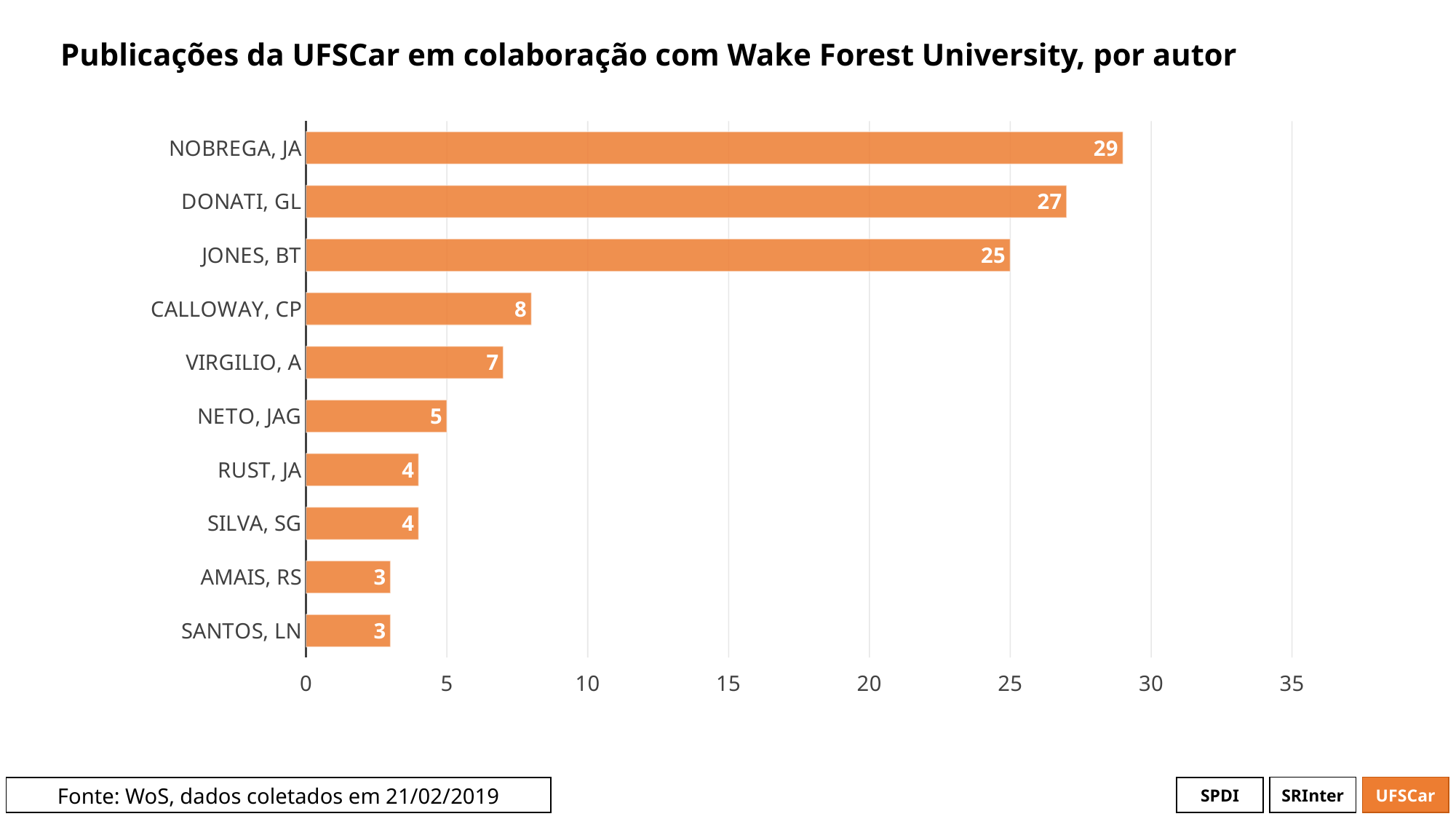
Which author has the highest number of publications? NOBREGA, JA How many authors are shown in the chart? 10 What is the value shown for CALLOWAY, CP? 8 What kind of chart is shown on the slide? bar chart Is the value for DONATI, GL greater or less than 25? greater What is the difference between the values for JONES, BT and CALLOWAY, CP? 17 How many publications does NOBREGA, JA have? 29 What is the value shown for SANTOS, LN? 3 What is the title of the chart? Publicações da UFSCar em colaboração com Wake Forest University, por autor What is the value shown for JONES, BT? 25 What is the difference between the values for NOBREGA, JA and DONATI, GL? 2 Which is larger, the value for VIRGILIO, A or the value for NETO, JAG? VIRGILIO, A